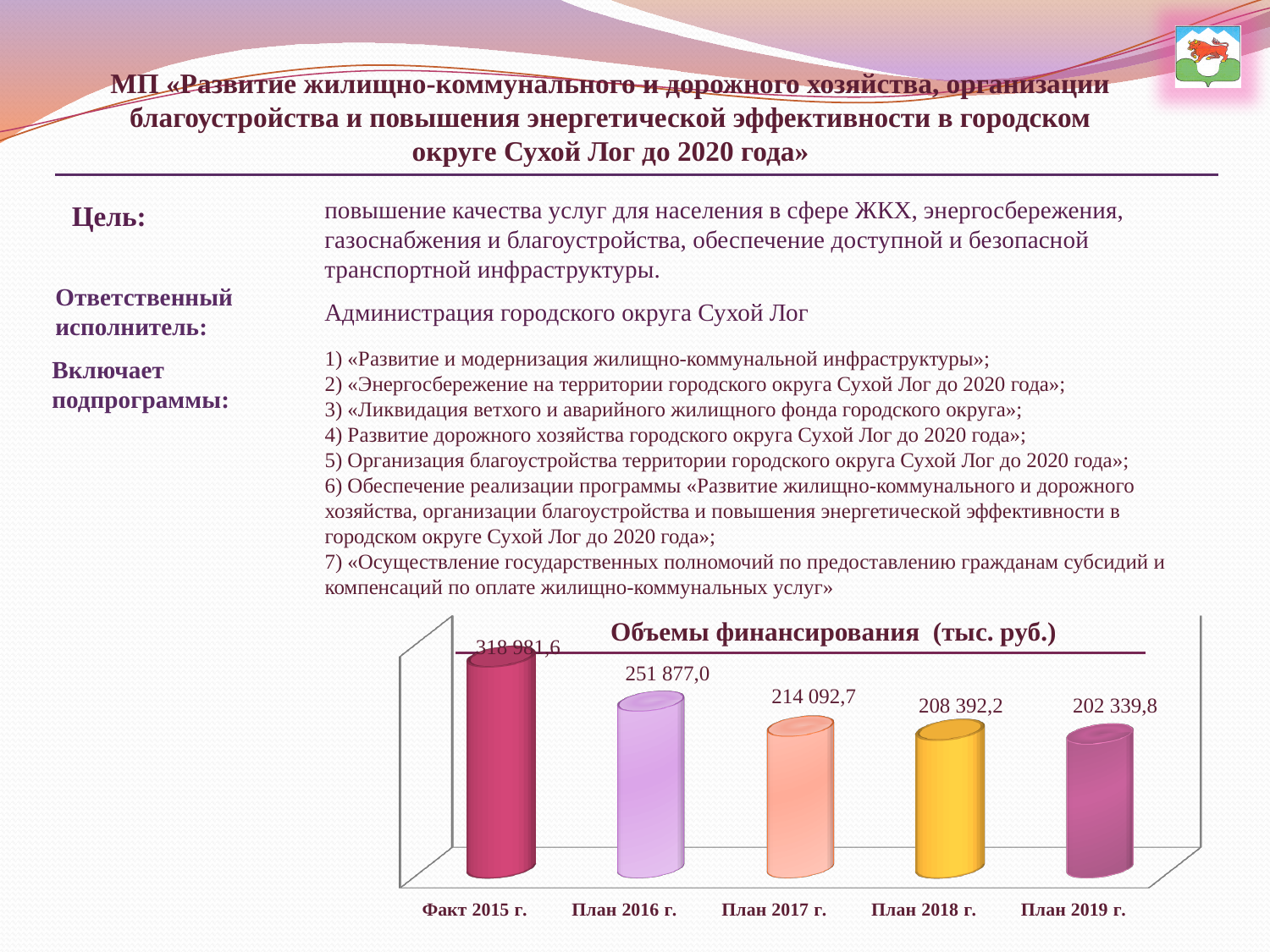
What is the value for План 2016 г. in the chart? 251 877,0 Which is larger, the value for План 2016 г. or the value for План 2018 г.? План 2016 г. What is the value for План 2019 г. in the chart? 202 339,8 How many categories are shown in the chart? 5 What kind of chart is shown on the slide? Bar chart Which category has the highest value in the chart? Факт 2015 г. What is the difference between the values for План 2016 г. and План 2017 г.? 37 784,3 What is the value for План 2017 г. in the chart? 214 092,7 What is the value for План 2018 г. in the chart? 208 392,2 What is the difference between the values for План 2018 г. and План 2019 г.? 6 052,4 Which category has the lowest value in the chart? План 2019 г. Do the values rise or fall from Факт 2015 г. to План 2019 г.? Fall